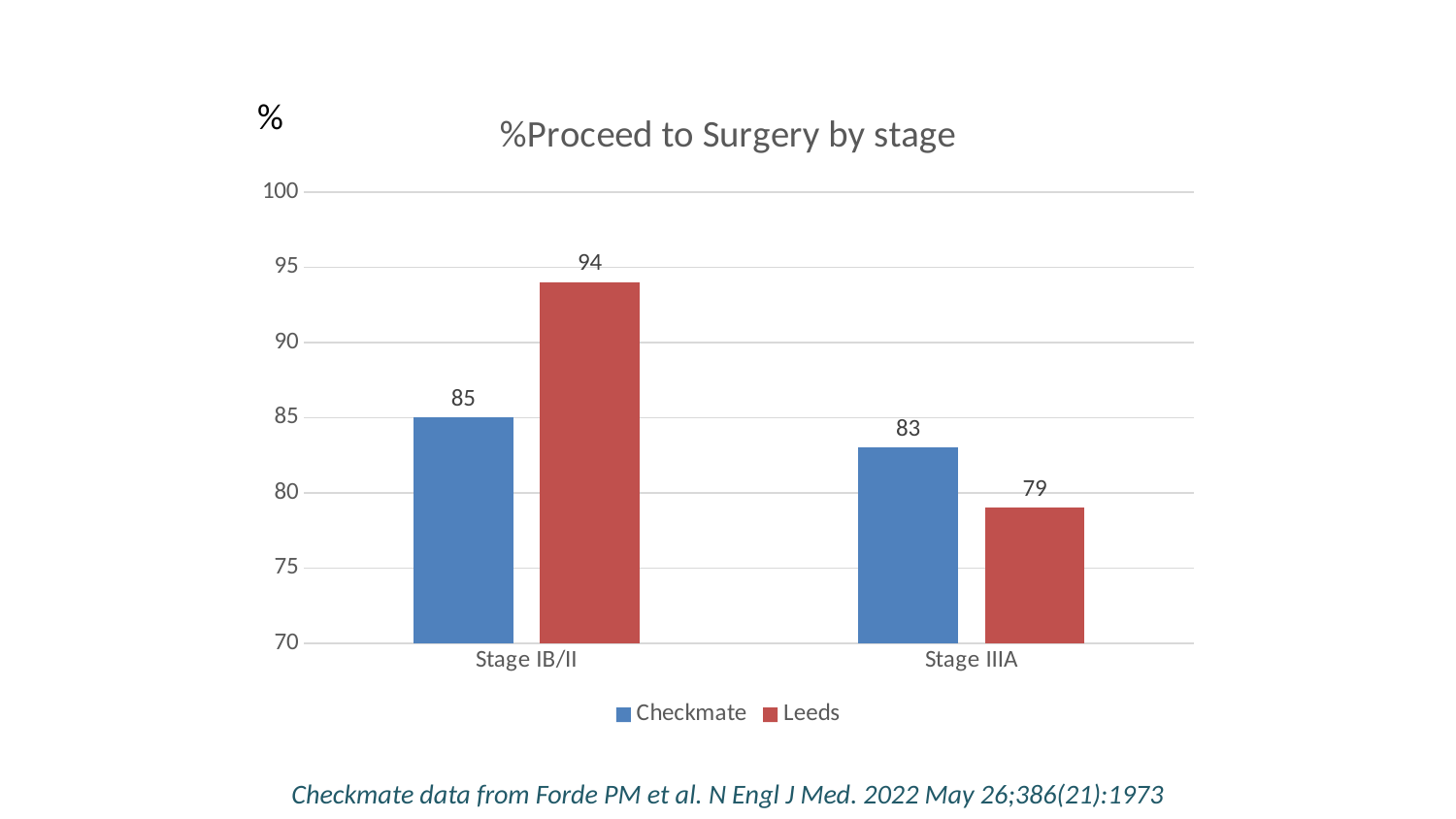
What is the difference between the Leeds and Checkmate values at Stage IB/II? 9 Which series has the highest value at Stage IB/II? Leeds Which is larger at Stage IIIA, Checkmate or Leeds? Checkmate How many series does the legend list? 2 What is the value for Leeds at Stage IIIA? 79 What is the value for Checkmate at Stage IIIA? 83 What kind of chart is shown on the slide? Bar chart What is the value for Leeds at Stage IB/II? 94 What is the value for Checkmate at Stage IB/II? 85 How many stage categories are shown on the x axis? 2 Is the value for Leeds at Stage IIIA greater or less than 80? less Which series has the lowest value at Stage IIIA? Leeds